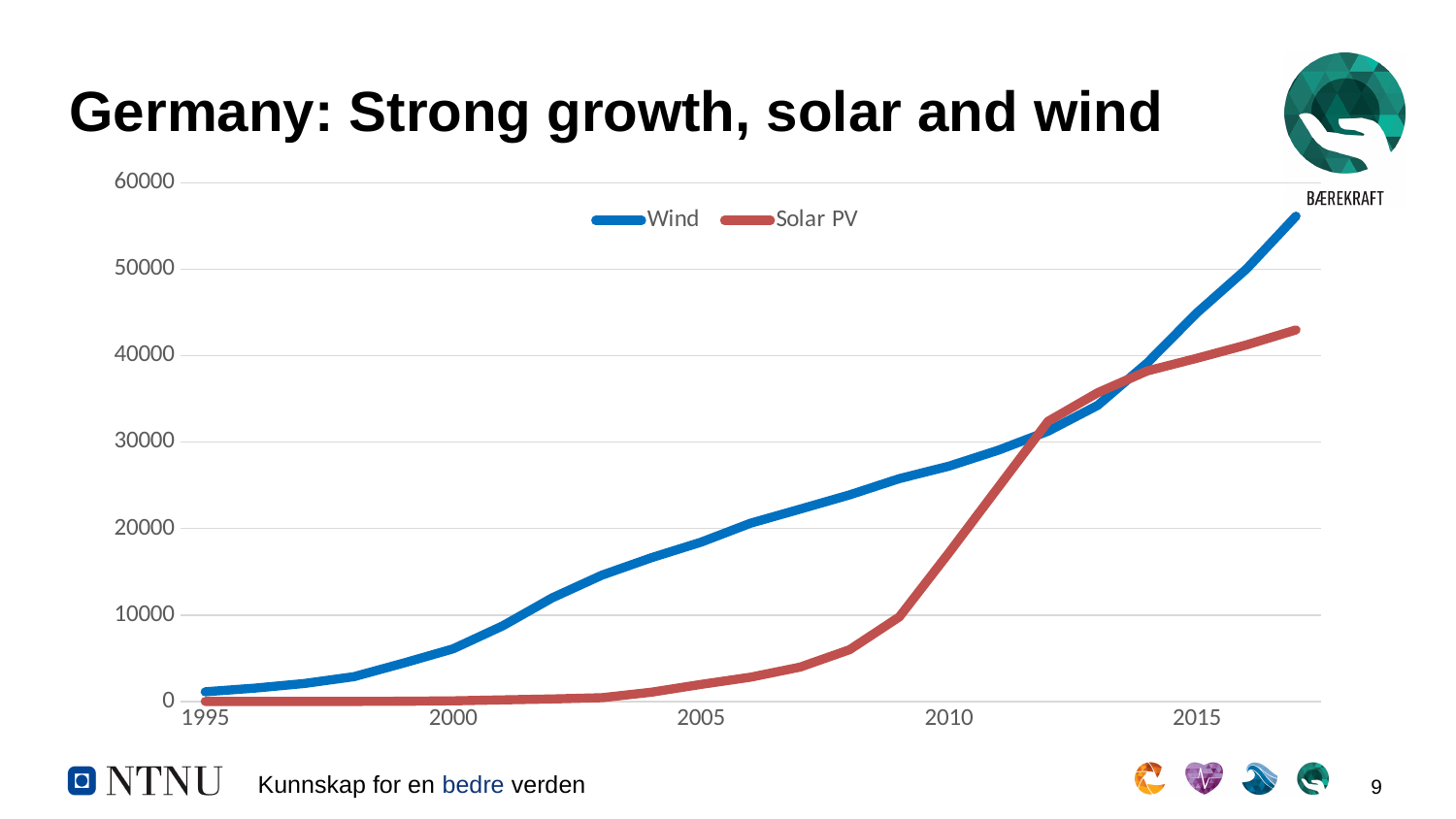
What kind of chart is shown on the slide? line chart Is the value for Wind in 2005 greater or less than 20000? less Is the value for Wind in 2010 greater or less than 20000? greater In 2005, which series has the larger value, Wind or Solar PV? Wind Does the Solar PV series rise or fall over the period shown? rise Is the value for Solar PV in 2005 greater or less than 10000? less How many series does the legend list? 2 What is the title of the chart on the slide? Germany: Strong growth, solar and wind Which colour is used for the Wind series? blue At the right-hand end of the chart, which series has the higher value, Wind or Solar PV? Wind Does the Wind series rise or fall from 1995 to the end of the chart? rise